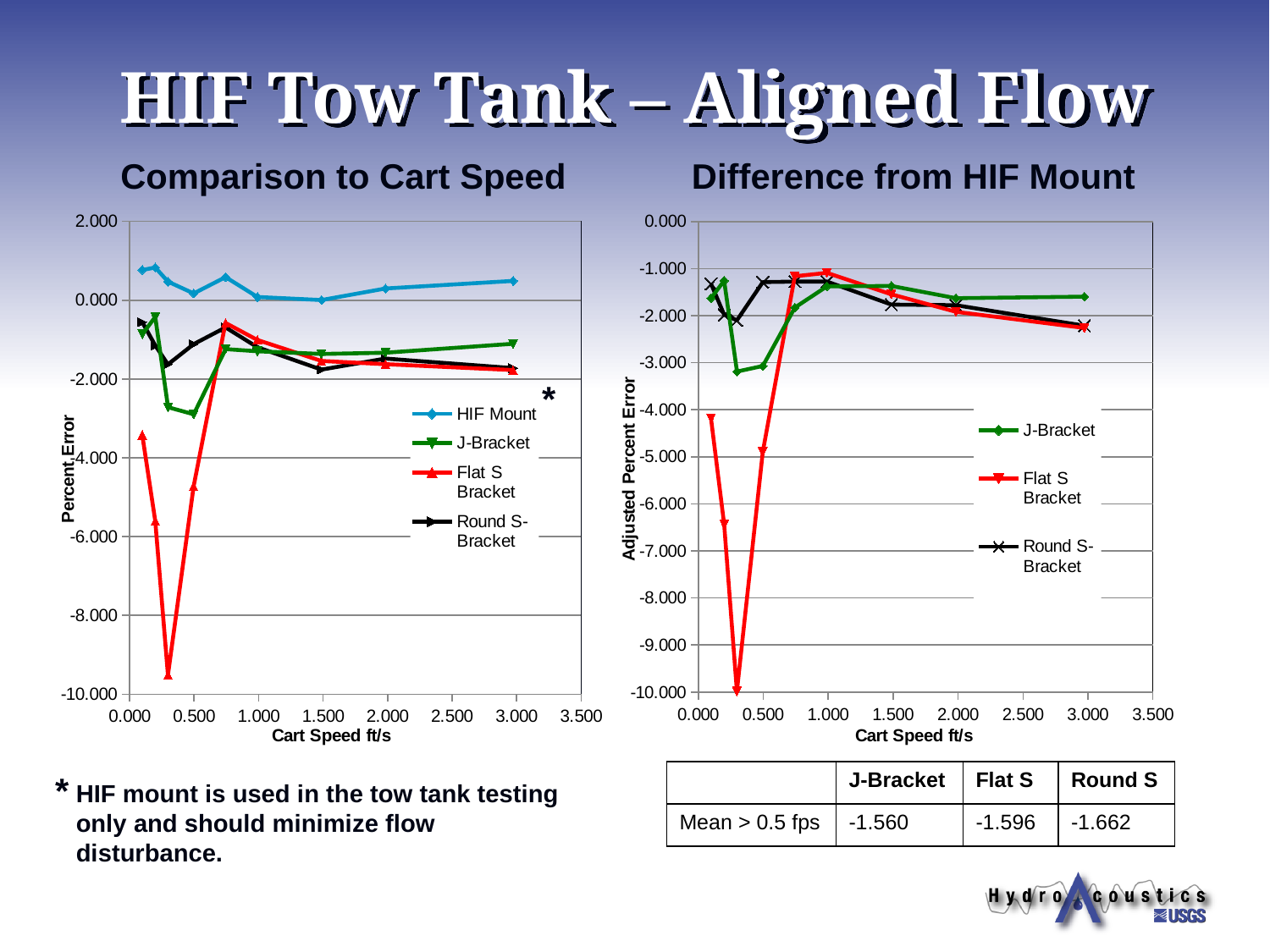
In the 'Comparison to Cart Speed' chart, which series reaches the lowest value? Flat S Bracket What kind of chart is the 'Comparison to Cart Speed' chart? Line chart How many series does the legend of the 'Difference from HIF Mount' chart list? 3 In the 'Comparison to Cart Speed' chart, which series has the highest values across the cart speeds? HIF Mount In the 'Comparison to Cart Speed' chart, is the lowest Flat S Bracket value greater or less than -8.000? less In the 'Difference from HIF Mount' chart, is the Round S-Bracket value at a cart speed of 3.000 greater or less than -3.000? greater What is the y-axis title of the 'Difference from HIF Mount' chart? Adjusted Percent Error In the 'Comparison to Cart Speed' chart, at a cart speed of about 0.300, which is higher: HIF Mount or Flat S Bracket? HIF Mount In the 'Difference from HIF Mount' chart, is the lowest Flat S Bracket value greater or less than -9.000? less How many series does the legend of the 'Comparison to Cart Speed' chart list? 4 In the 'Difference from HIF Mount' chart, does the Flat S Bracket line rise or fall between cart speeds of 0.300 and 1.000? rise